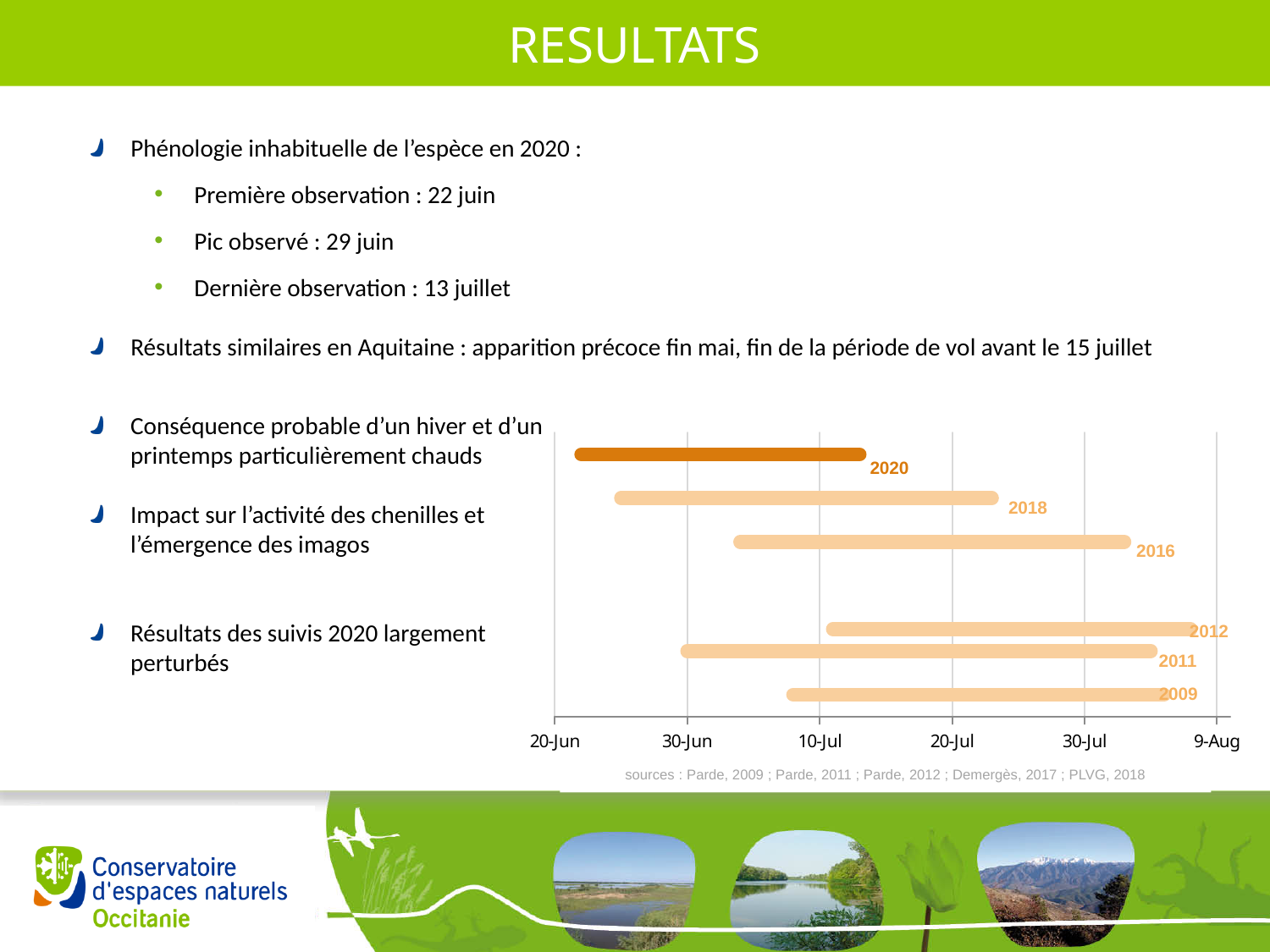
Does the bar for 2016 start before or after 30-Jun? after Which year's bar starts earliest on the x axis? 2020 Which year's bar is drawn in a darker orange colour than the others? 2020 What kind of chart is shown on the slide? bar chart Which year has the longest bar in the chart? 2011 Which year's bar extends furthest to the right (ends latest)? 2012 Does the bar for 2009 start before or after 10-Jul? before Does the bar for 2020 end before or after 10-Jul? after Which year has the shortest bar in the chart? 2020 What is the first date label shown on the x axis of the chart? 20-Jun How many years (bars) are plotted in the chart? 6